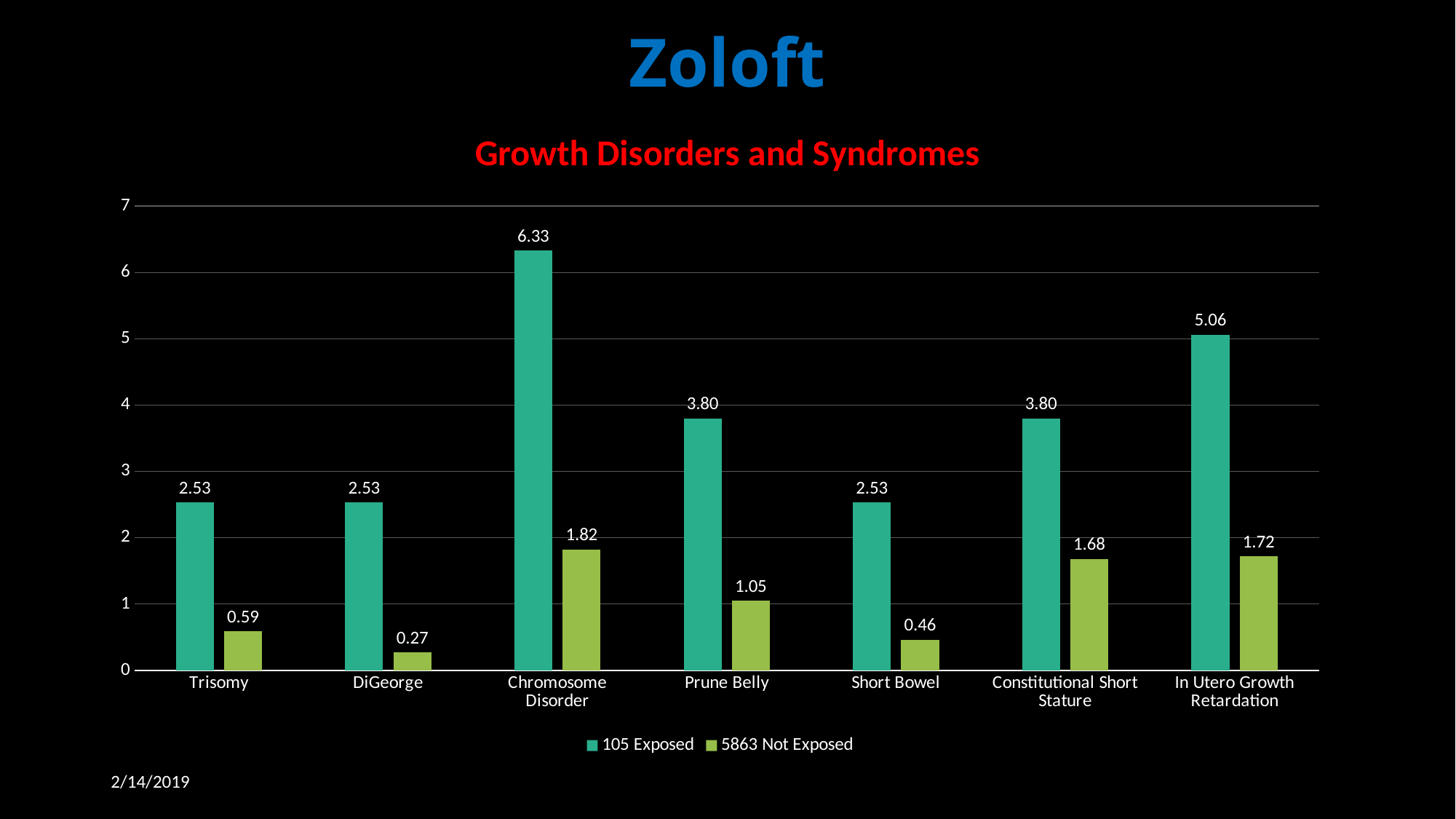
How many series does the legend list? 2 What is the title of the chart? Growth Disorders and Syndromes What is the difference between the 105 Exposed and 5863 Not Exposed values for Prune Belly? 2.75 How many categories are shown on the x axis? 7 What kind of chart is shown on the slide? bar chart Which category has the lowest value in the 5863 Not Exposed series? DiGeorge Which category has the highest value in the 105 Exposed series? Chromosome Disorder Is the 105 Exposed value for Short Bowel greater or less than 3? less What is the value for DiGeorge in the 5863 Not Exposed series? 0.27 What is the value for In Utero Growth Retardation in the 105 Exposed series? 5.06 What is the value for Chromosome Disorder in the 105 Exposed series? 6.33 Which is larger: the 5863 Not Exposed value for Constitutional Short Stature or for In Utero Growth Retardation? In Utero Growth Retardation